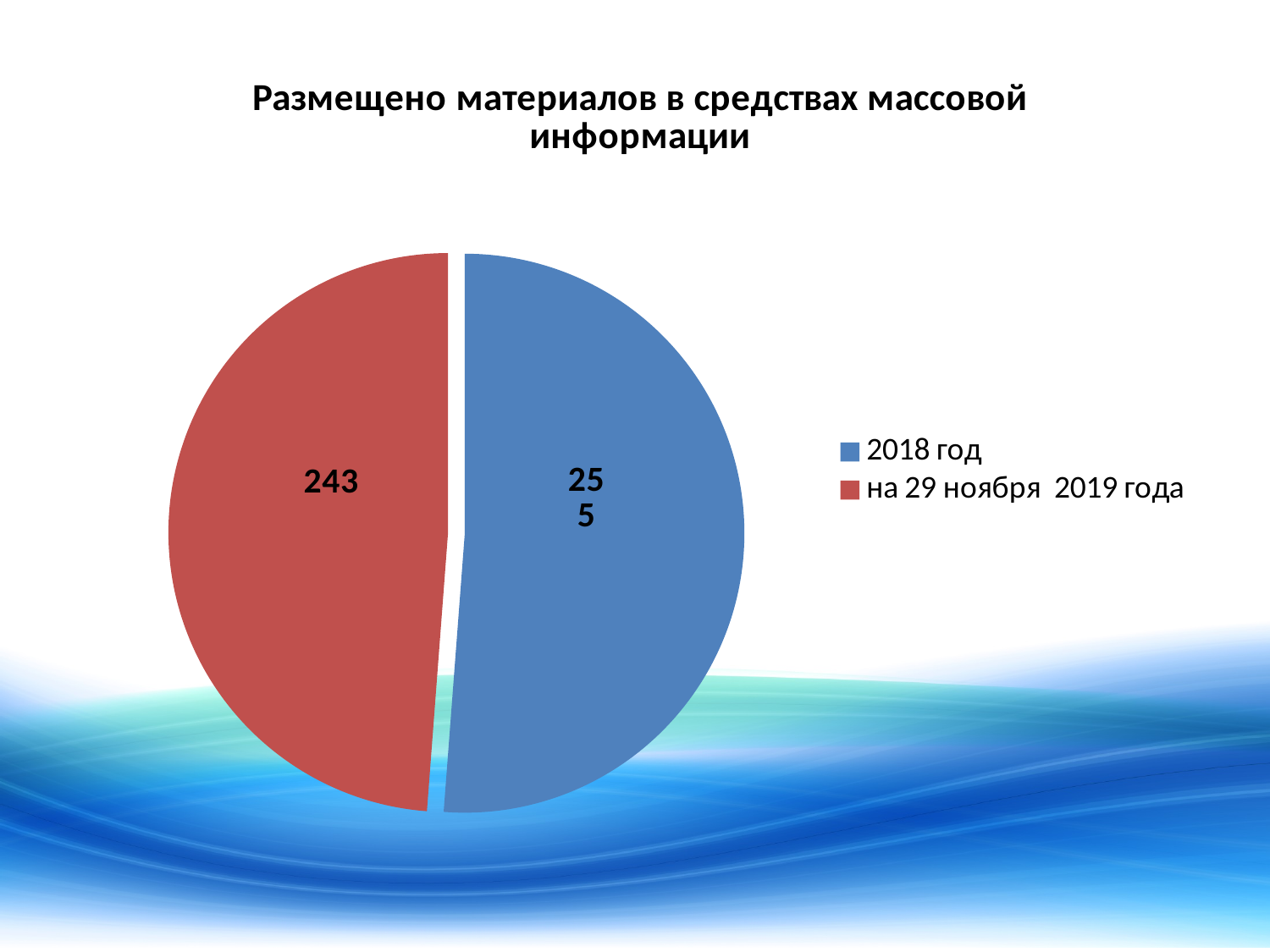
How many entries does the legend list? 2 Which is larger, the value for 2018 год or the value for на 29 ноября 2019 года? 2018 год What is the total of the two slices in the pie chart? 498 What is the difference between the value for 2018 год and the value for на 29 ноября 2019 года? 12 What is the value for 2018 год? 255 What is the value for на 29 ноября 2019 года? 243 Which colour represents 2018 год in the pie chart? blue Which category has the smallest slice? на 29 ноября 2019 года How many slices does the pie chart have? 2 What is the title of the chart? Размещено материалов в средствах массовой информации Which category has the largest slice? 2018 год What kind of chart is shown on the slide? pie chart